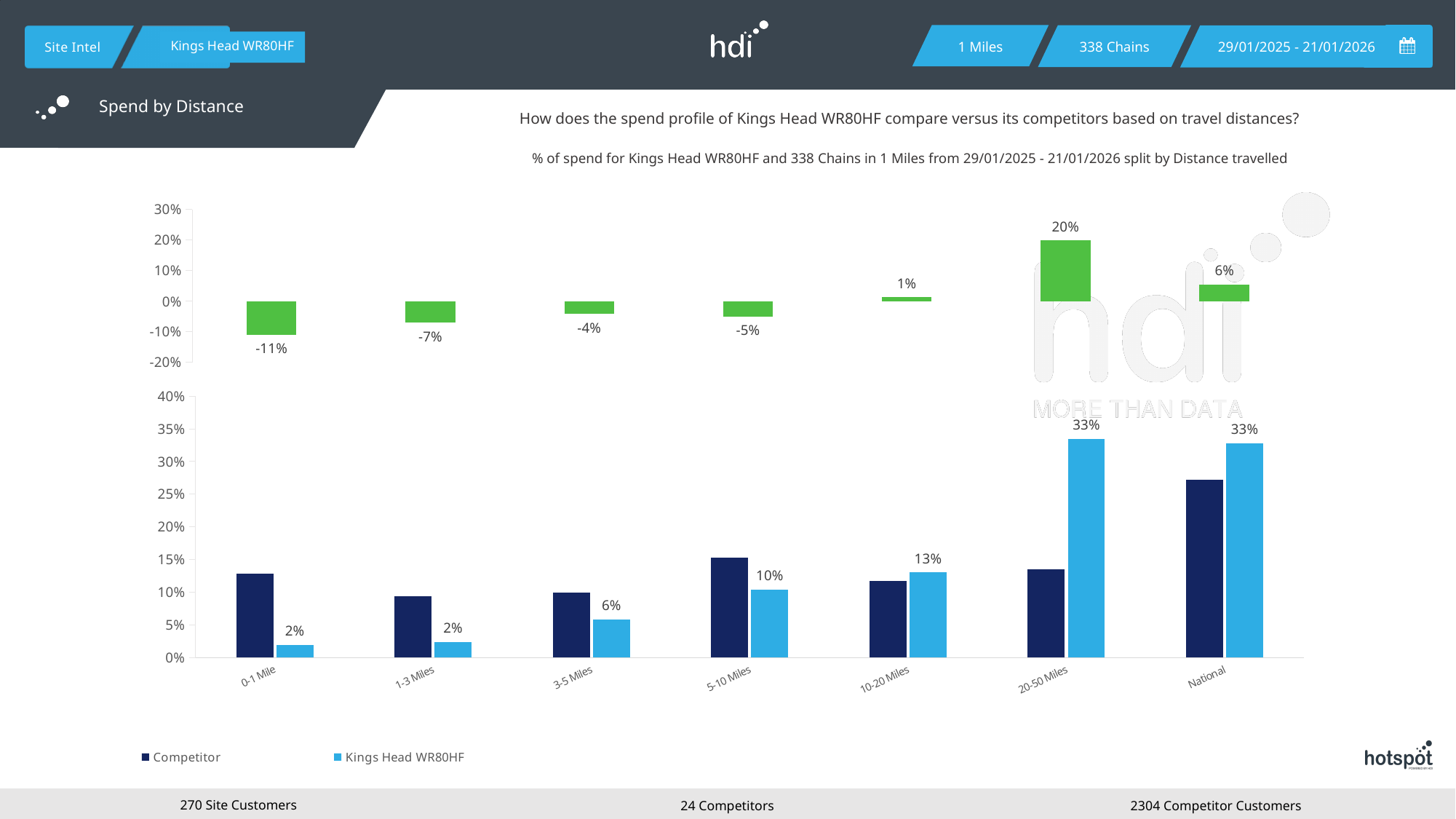
In the top chart, what is the value for 5-10 Miles? -5% In the top chart, which distance band has the lowest value? 0-1 Mile In the bottom chart, is the Competitor value for 1-3 Miles greater or less than 10%? less How many distance categories are shown on the x axis of the bottom chart? 7 What kind of chart is the bottom chart? bar chart In the bottom chart, is the Competitor value for National greater or less than 25%? greater In the top chart, what is the value for 20-50 Miles? 20% In the top chart, which distance band has the highest value? 20-50 Miles In the bottom chart, what is the Kings Head WR80HF value for 10-20 Miles? 13% How many series does the legend of the bottom chart list? 2 In the bottom chart, what is the difference between the Kings Head WR80HF values for 20-50 Miles and 0-1 Mile? 31% In the bottom chart, for 0-1 Mile, which series has the larger value, Competitor or Kings Head WR80HF? Competitor